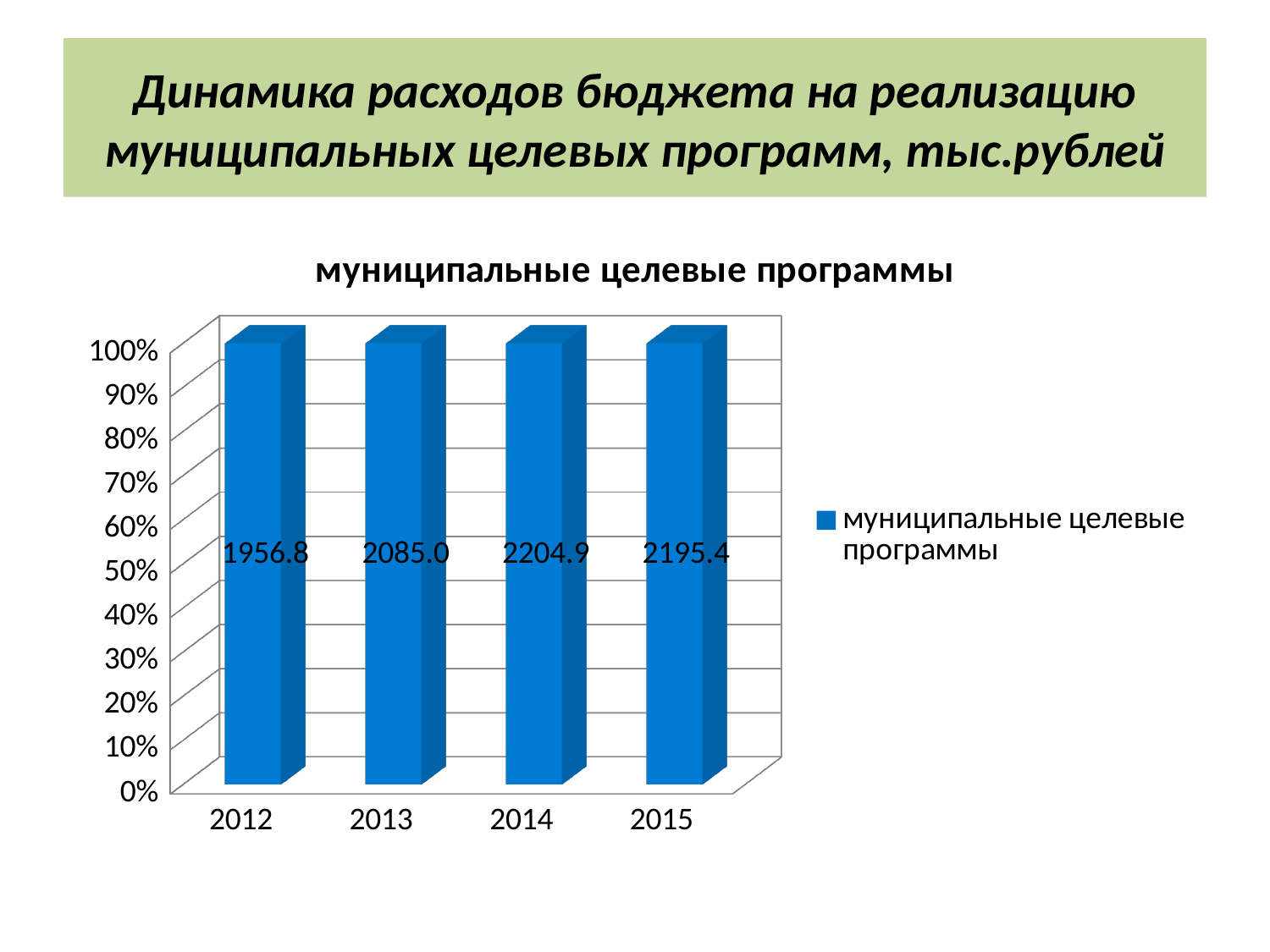
What is the difference between the labelled values for 2013 and 2012? 128.2 What is the data label on the bar for 2015? 2195.4 Which year has the lowest labelled value? 2012 What is the data label on the bar for 2013? 2085.0 What kind of chart is shown on the slide? Bar chart Which year has the larger labelled value, 2013 or 2015? 2015 What is the data label on the bar for 2012? 1956.8 What is the difference between the labelled values for 2014 and 2015? 9.5 How many years are shown on the x axis? 4 What is the data label on the bar for 2014? 2204.9 Which year has the highest labelled value? 2014 How many series does the legend list? 1